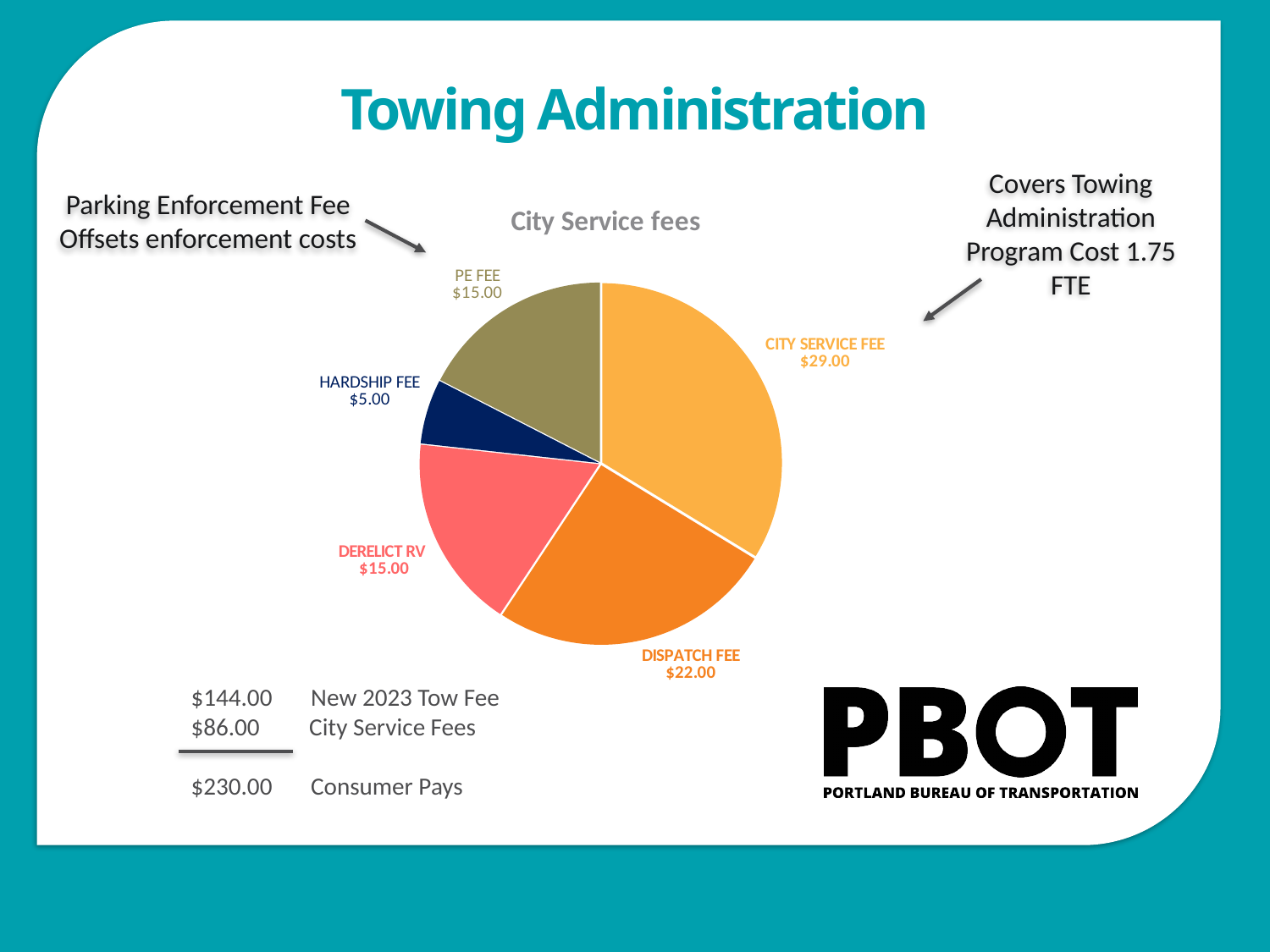
What is the difference between the City Service Fee and the Dispatch Fee? $7.00 How many slices does the pie chart have? 5 What is the value of the Hardship Fee slice? $5.00 What is the total of all the slices in the pie chart? $86.00 What type of chart is shown on the slide? Pie chart What is the value of the City Service Fee slice? $29.00 Which slice of the pie chart is the smallest? Hardship Fee What is the title of the chart? City Service fees Which slice of the pie chart is the largest? City Service Fee Which is larger, the Dispatch Fee or the PE Fee? Dispatch Fee What is the value of the Derelict RV slice? $15.00 What is the value of the Dispatch Fee slice? $22.00